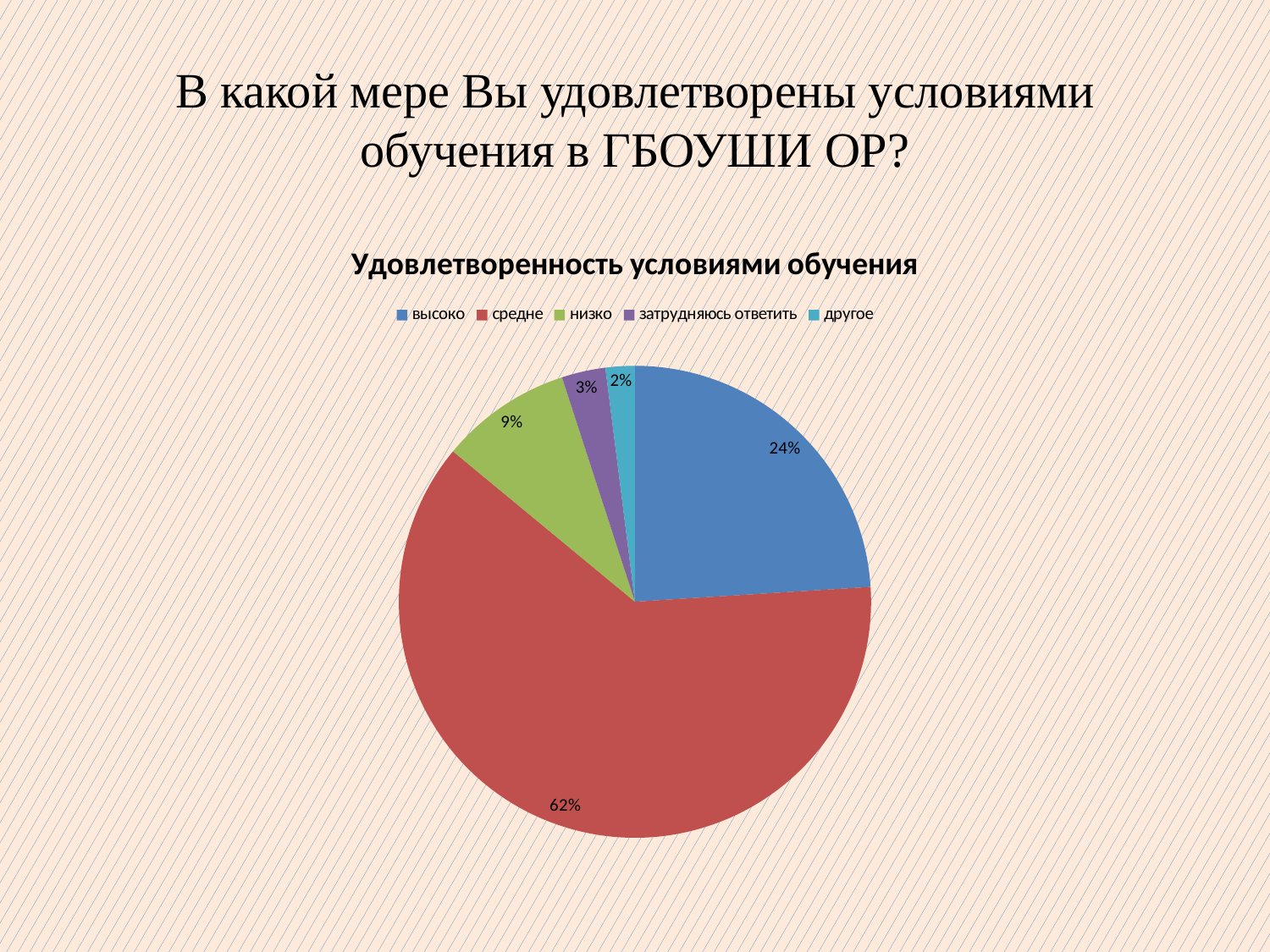
What percentage of respondents answered "затрудняюсь ответить"? 3% What is the title of the chart? Удовлетворенность условиями обучения Which category has the smallest share of the pie? другое How many categories does the legend list? 5 What percentage of respondents answered "средне"? 62% What type of chart is shown on the slide? pie chart Which is larger, the share for "низко" or the share for "затрудняюсь ответить"? низко What percentage of respondents answered "низко"? 9% What is the difference in percentage points between "средне" and "высоко"? 38 Which category has the largest share of the pie? средне What percentage of respondents answered "высоко"? 24% What percentage of respondents answered "другое"? 2%